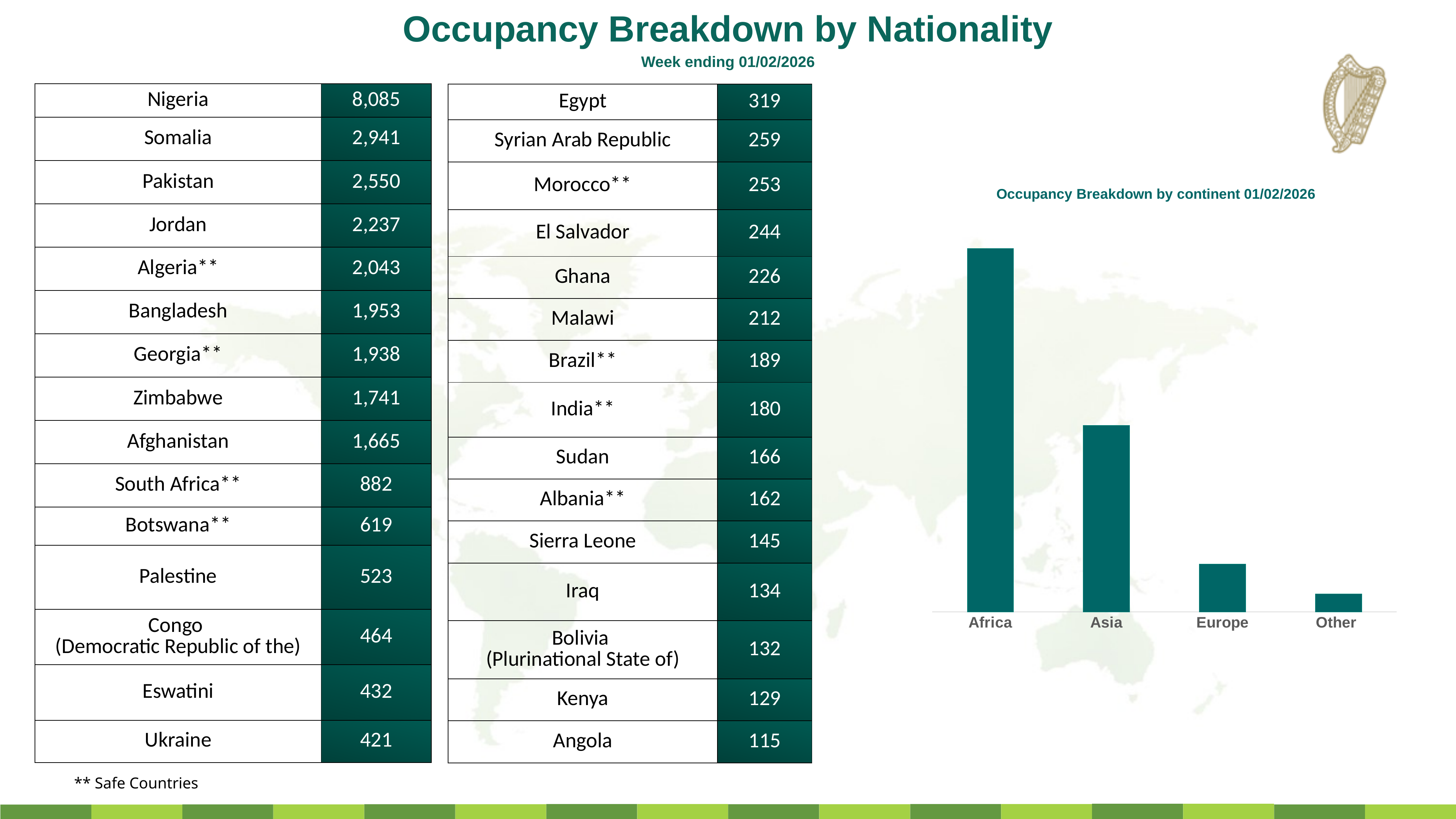
In the 'Occupancy Breakdown by continent 01/02/2026' chart, which category has the lowest bar? Other In the 'Occupancy Breakdown by continent 01/02/2026' chart, which continent has the second-highest bar? Asia In the 'Occupancy Breakdown by continent 01/02/2026' chart, which continent has the highest bar? Africa What kind of chart is the 'Occupancy Breakdown by continent 01/02/2026' chart? Bar chart In the 'Occupancy Breakdown by continent 01/02/2026' chart, which is larger, the bar for Europe or the bar for Other? Europe How many categories are shown on the x axis of the 'Occupancy Breakdown by continent 01/02/2026' chart? 4 What are the category labels on the x axis of the 'Occupancy Breakdown by continent 01/02/2026' chart, from left to right? Africa, Asia, Europe, Other In the 'Occupancy Breakdown by continent 01/02/2026' chart, do the bars rise or fall from left to right along the x axis? Fall What is the title of the bar chart on the right side of the slide? Occupancy Breakdown by continent 01/02/2026 In the 'Occupancy Breakdown by continent 01/02/2026' chart, which is larger, the bar for Asia or the bar for Europe? Asia In the 'Occupancy Breakdown by continent 01/02/2026' chart, which is larger, the bar for Africa or the bar for Asia? Africa